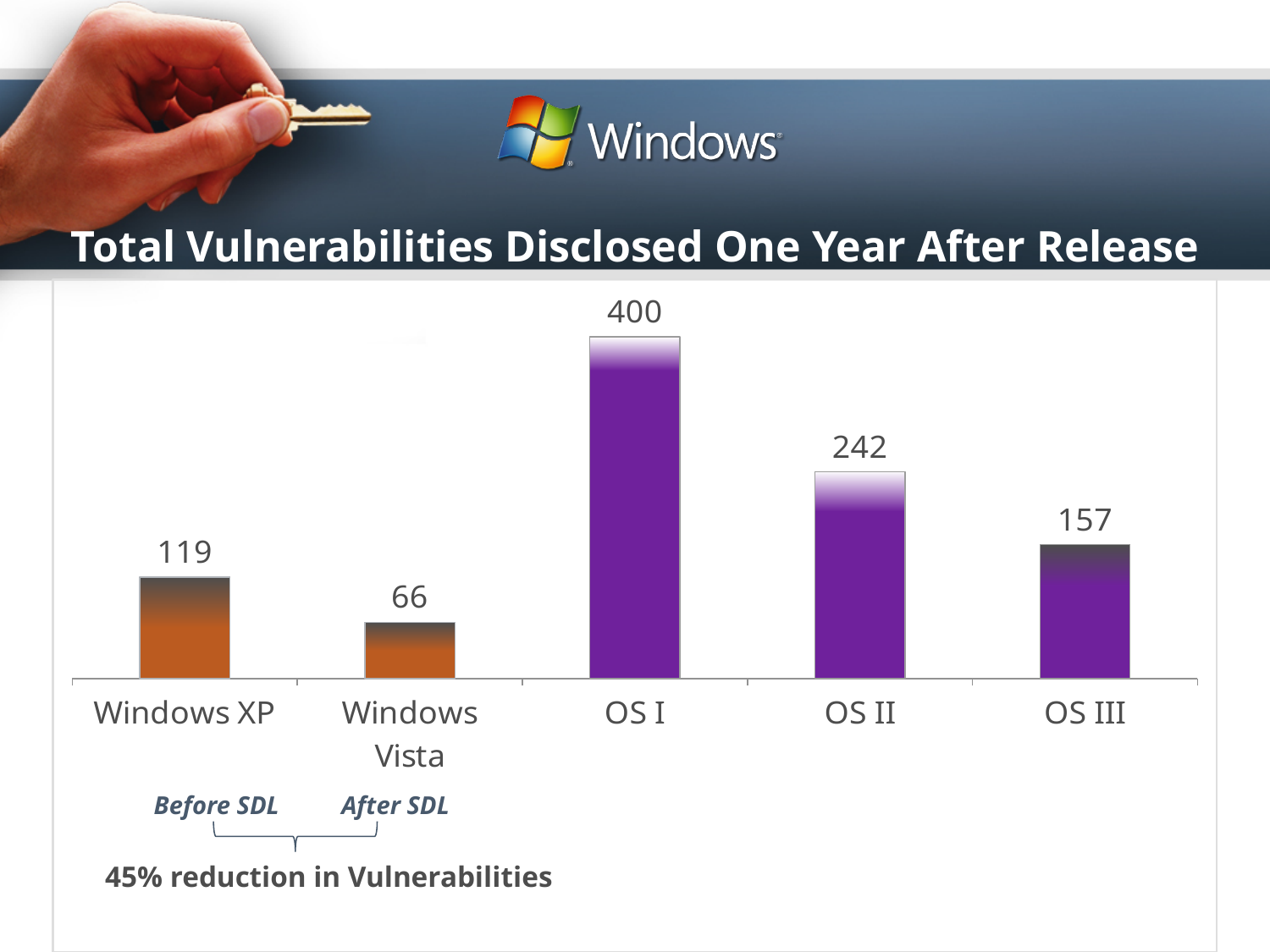
How many categories are shown on the chart? 5 Which category has the highest value? OS I What is the difference between the values for OS I and OS II? 158 Which is larger, the value for OS III or the value for Windows XP? OS III What is the value for OS III? 157 What is the value for Windows Vista? 66 What is the value for OS I? 400 What is the difference between the values for Windows XP and Windows Vista? 53 Which category has the lowest value? Windows Vista What kind of chart is shown on the slide? Bar chart What is the value for OS II? 242 What is the value for Windows XP? 119